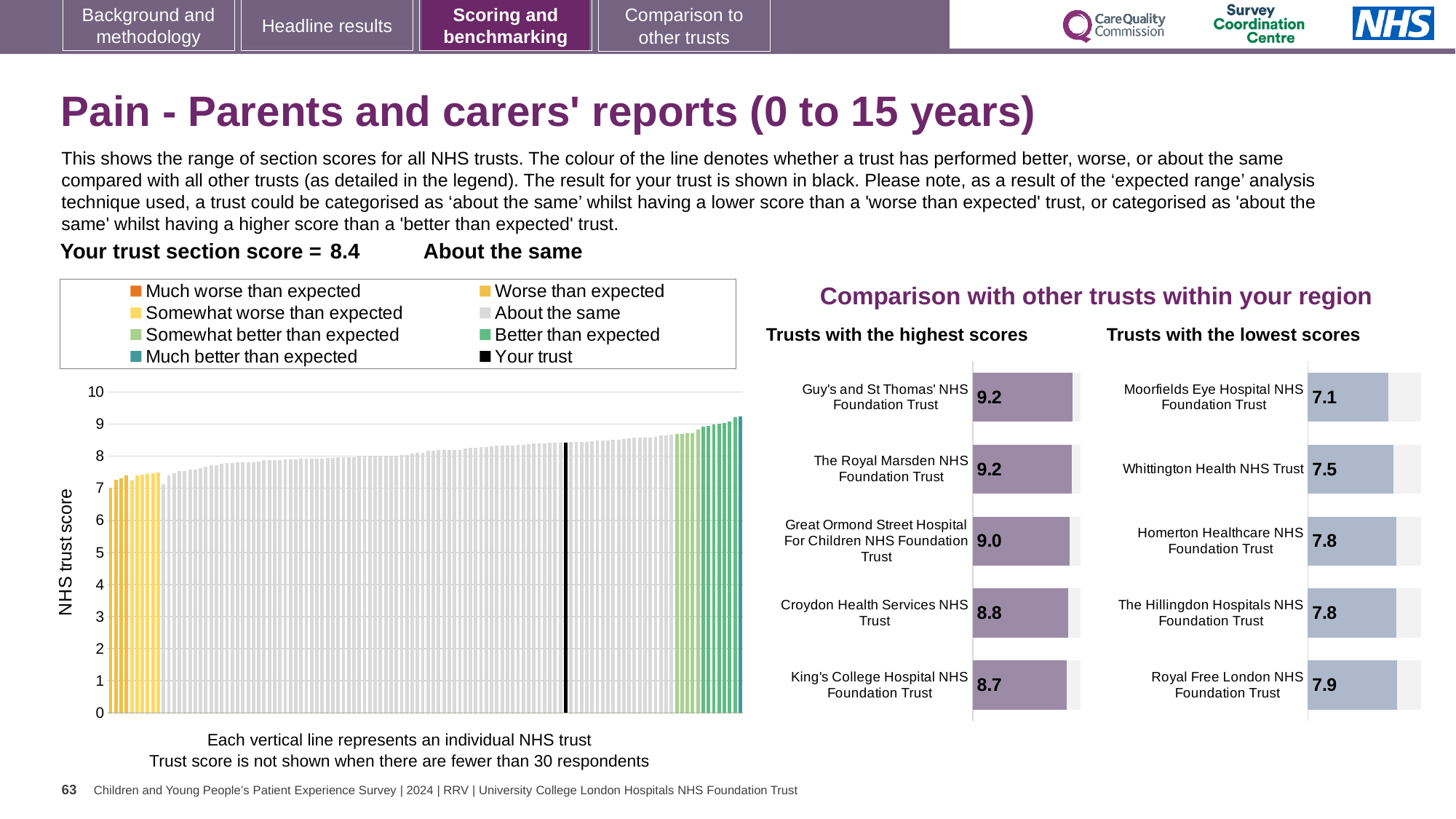
On the 'Trusts with the lowest scores' chart, what is the difference between the scores of Royal Free London NHS Foundation Trust and Moorfields Eye Hospital NHS Foundation Trust? 0.8 On the 'Trusts with the highest scores' chart, which trust has the lowest score? King's College Hospital NHS Foundation Trust How many entries does the legend above the main 'NHS trust score' chart list? 8 Which has the higher score: Croydon Health Services NHS Trust on the highest-scores chart or Homerton Healthcare NHS Foundation Trust on the lowest-scores chart? Croydon Health Services NHS Trust On the main 'NHS trust score' chart on the left, what is the section score for your trust? 8.4 On the main 'NHS trust score' chart on the left, do the values rise or fall from left to right? rise How many trusts are shown on the 'Trusts with the lowest scores' chart? 5 On the 'Trusts with the lowest scores' chart, which trust has the lowest score? Moorfields Eye Hospital NHS Foundation Trust On the main 'NHS trust score' chart on the left, is the value of the leftmost bar greater or less than 8? less On the 'Trusts with the lowest scores' chart, what is the score for Whittington Health NHS Trust? 7.5 On the 'Trusts with the highest scores' chart, what is the difference between the scores of Guy's and St Thomas' NHS Foundation Trust and King's College Hospital NHS Foundation Trust? 0.5 On the 'Trusts with the highest scores' chart, what is the score for Great Ormond Street Hospital For Children NHS Foundation Trust? 9.0